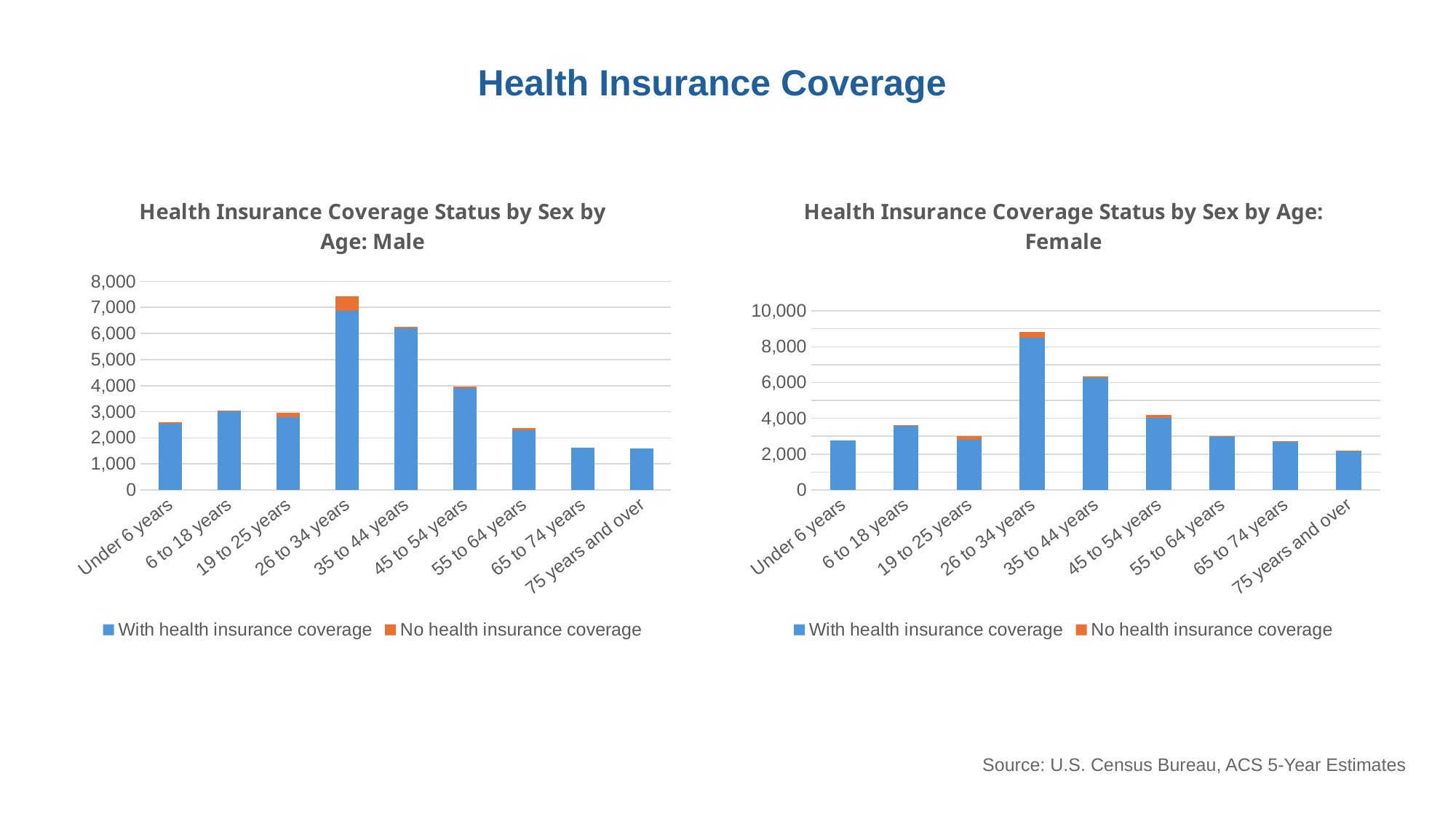
How many series does the legend of the 'Health Insurance Coverage Status by Sex by Age: Male' chart list? 2 How many age categories are shown on the x axis of the 'Health Insurance Coverage Status by Sex by Age: Female' chart? 9 In the 'Health Insurance Coverage Status by Sex by Age: Male' chart, is the total bar for 35 to 44 years greater or less than 5,000? greater What kind of chart is the 'Health Insurance Coverage Status by Sex by Age: Male' chart? Stacked bar chart In the 'Health Insurance Coverage Status by Sex by Age: Female' chart, which colour represents 'No health insurance coverage'? Orange In the 'Health Insurance Coverage Status by Sex by Age: Female' chart, which age group has the tallest bar? 26 to 34 years In the 'Health Insurance Coverage Status by Sex by Age: Male' chart, which bar is taller: 45 to 54 years or 55 to 64 years? 45 to 54 years In the 'Health Insurance Coverage Status by Sex by Age: Male' chart, which age group has the tallest bar? 26 to 34 years In the 'Health Insurance Coverage Status by Sex by Age: Male' chart, is the total bar for Under 6 years greater or less than 2,000? greater In the 'Health Insurance Coverage Status by Sex by Age: Female' chart, is the total bar for 26 to 34 years greater or less than 8,000? greater In the 'Health Insurance Coverage Status by Sex by Age: Female' chart, which age group has the shortest bar? 75 years and over